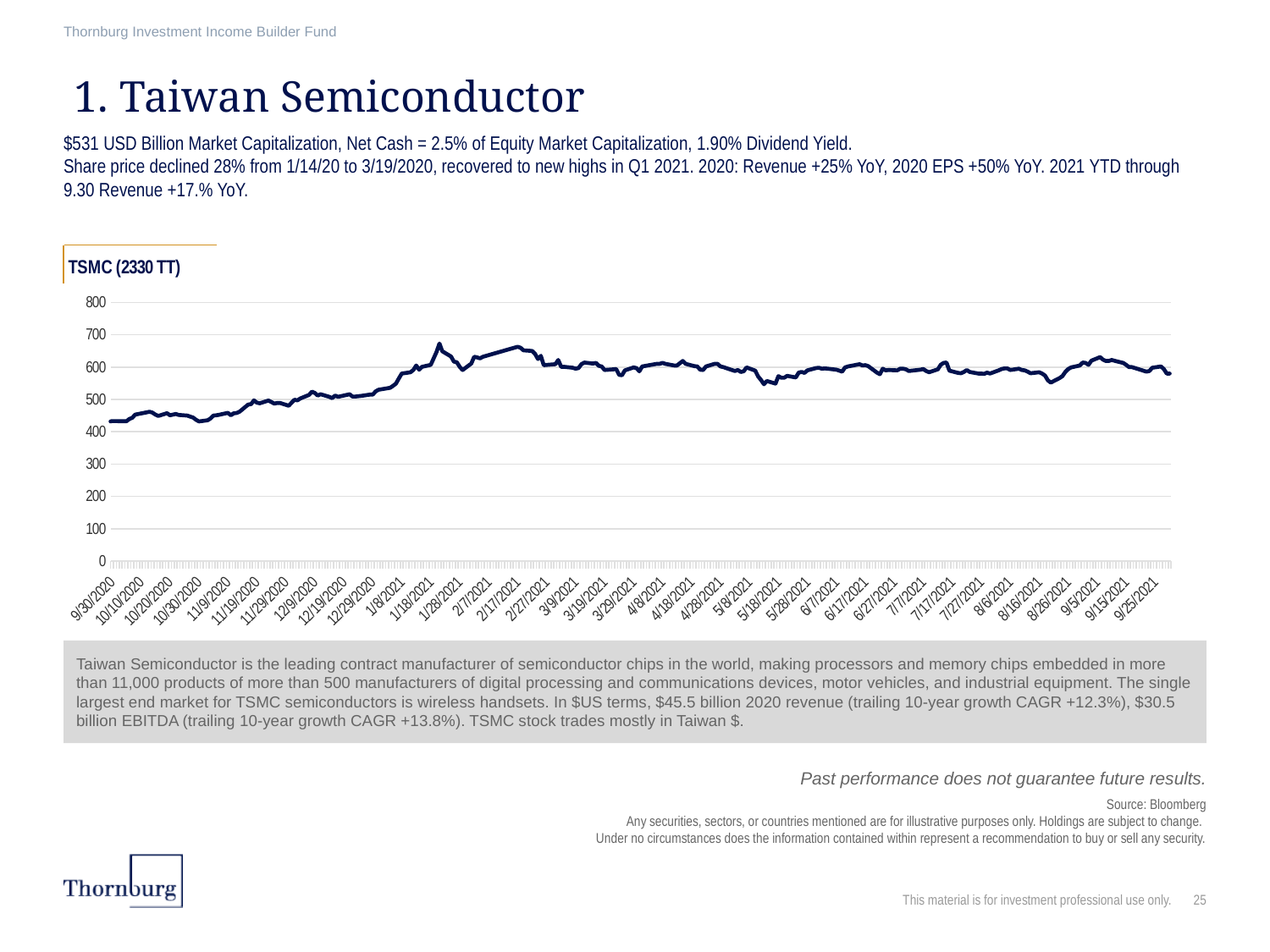
What is the title of the chart? TSMC (2330 TT) What is the first date label on the chart's horizontal axis? 9/30/2020 Overall, does the line rise or fall from 9/30/2020 to 9/25/2021? rise Which is larger, the value for 9/30/2020 or the value for 9/25/2021? 9/25/2021 What is the last date label on the chart's horizontal axis? 9/25/2021 What kind of chart is shown on the slide? line chart Is the value for 9/25/2021 greater or less than 500? greater Is the value for 9/30/2020 greater or less than 500? less What is the highest value shown on the chart's vertical axis? 800 How many lines are plotted on the chart? 1